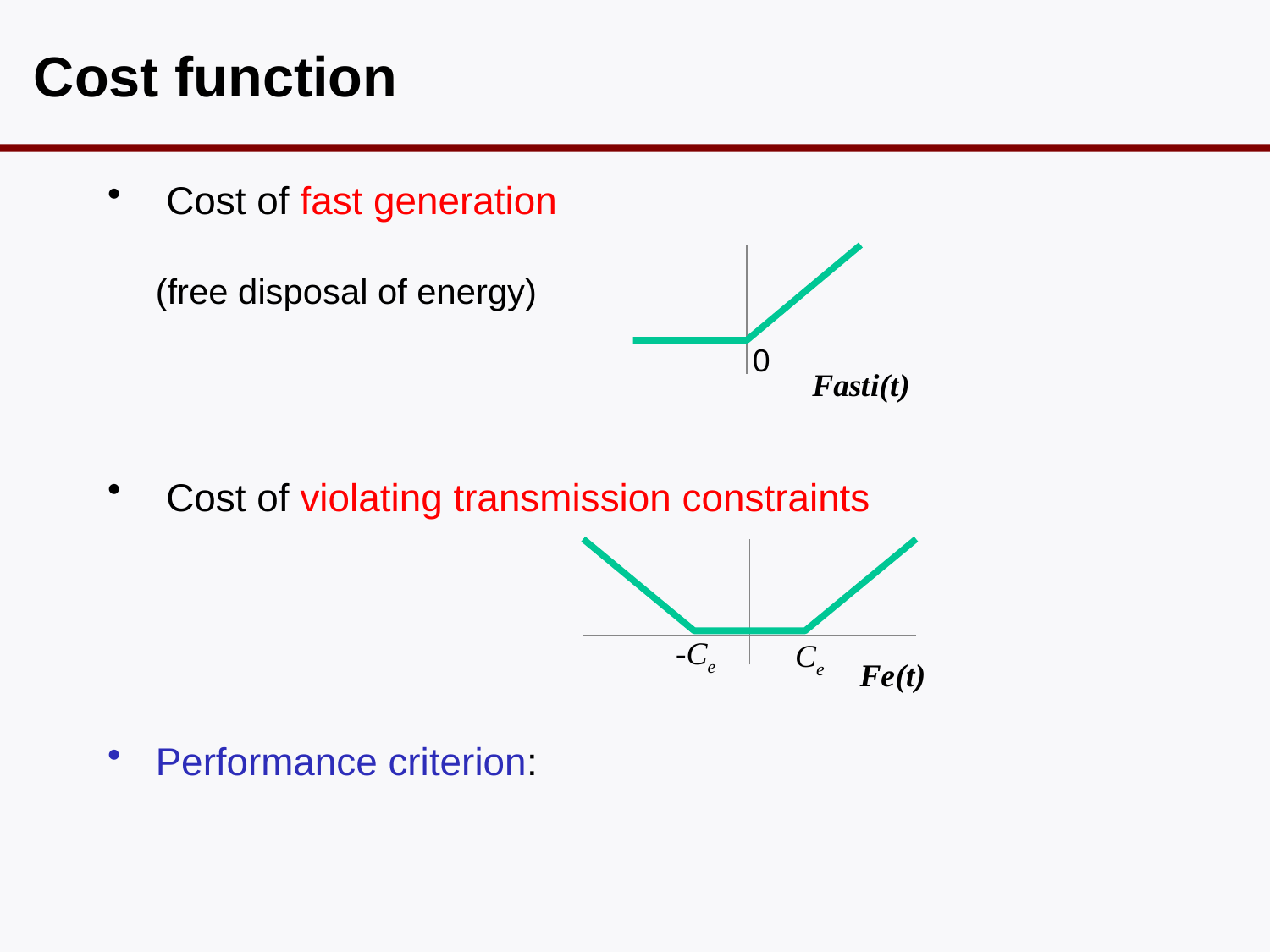
In the top chart (cost of fast generation), does the line rise, fall or stay flat for values of Fasti(t) to the left of 0? stay flat In the top chart (cost of fast generation), does the line rise or stay flat as Fasti(t) increases to the right of 0? rise What is the x-axis label of the bottom chart? Fe(t) What kind of chart is the top chart, labelled Fasti(t) on its x axis? line chart In the bottom chart (cost of violating transmission constraints), does the line rise, fall or stay flat between -Ce and Ce? stay flat What kind of chart is the bottom chart, labelled Fe(t) on its x axis? line chart What is the x-axis label of the top chart? Fasti(t)